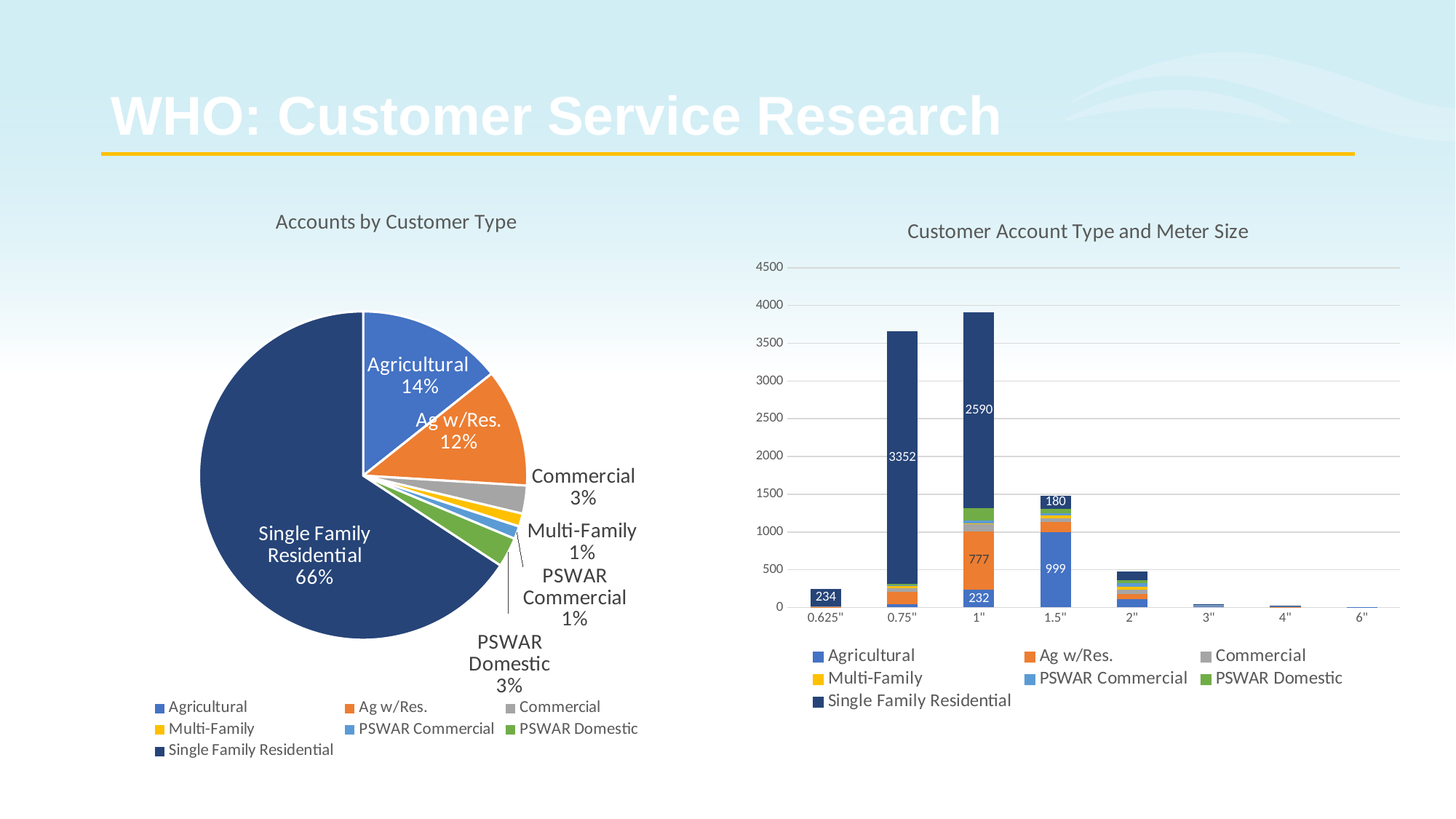
How many meter sizes are shown on the x axis of the Customer Account Type and Meter Size chart? 8 In the Accounts by Customer Type pie chart, how many percentage points larger is Agricultural than Ag w/Res.? 2 In the Accounts by Customer Type pie chart, what percentage is Agricultural? 14% In the Customer Account Type and Meter Size chart, what is the Agricultural value for the 1.5" meter size? 999 How many series does the legend of the Customer Account Type and Meter Size chart list? 7 In the Accounts by Customer Type pie chart, what share of accounts is Single Family Residential? 66% How many customer types are shown in the Accounts by Customer Type pie chart? 7 In the Customer Account Type and Meter Size chart, what is the Single Family Residential value for the 0.75" meter size? 3352 What kind of chart is Customer Account Type and Meter Size? Stacked bar chart In the Customer Account Type and Meter Size chart, what is the Ag w/Res. value for the 1" meter size? 777 In the Customer Account Type and Meter Size chart, what is the difference between the Single Family Residential values for 0.75" and 1"? 762 In the Accounts by Customer Type pie chart, which customer type has the largest slice? Single Family Residential